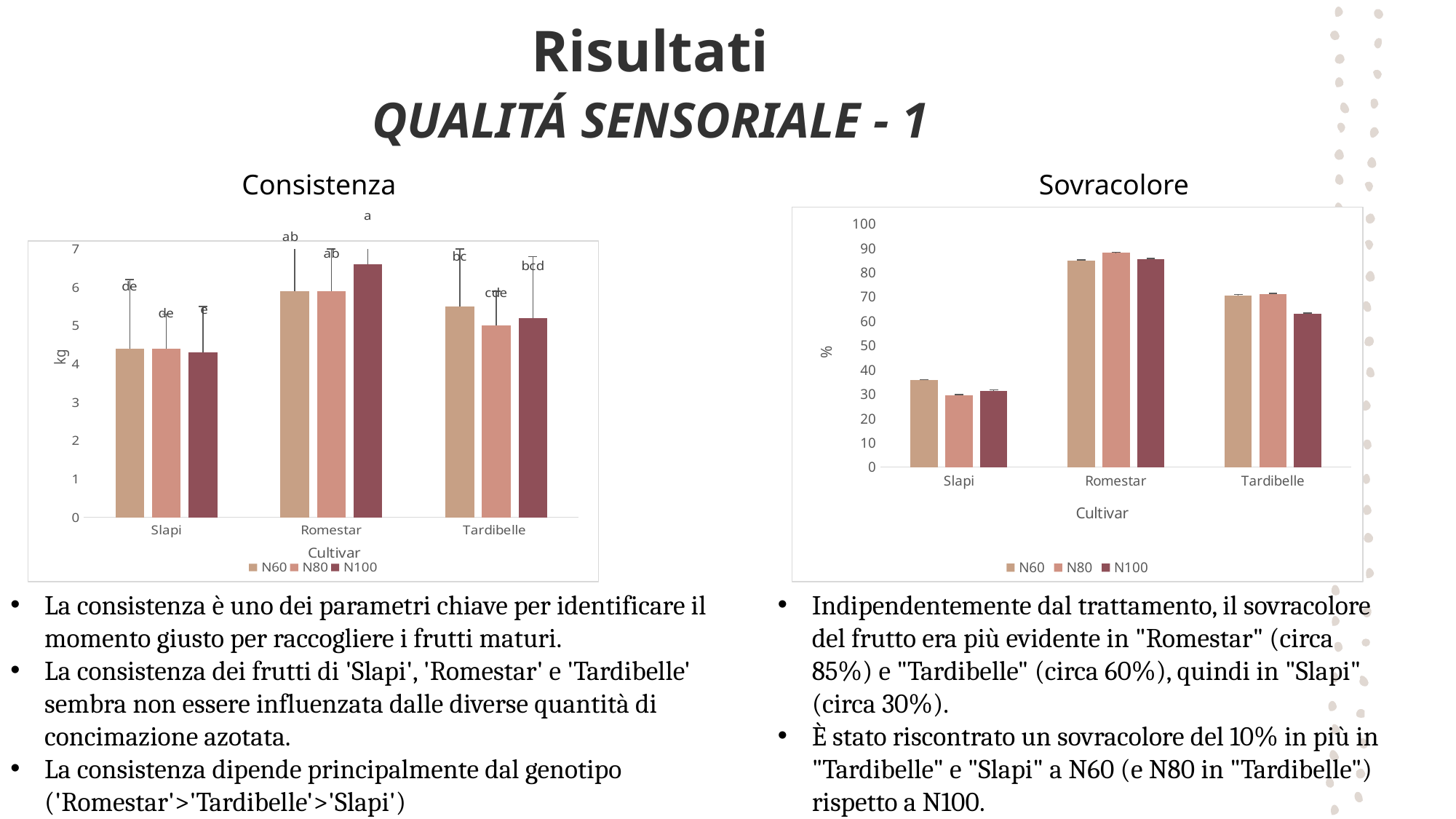
In the Sovracolore chart, is the N100 value for Tardibelle greater or less than 70? less What is the y-axis label of the Sovracolore chart? % In the Consistenza chart, which cultivar has the highest N100 bar? Romestar In the Sovracolore chart, is the N80 value for Romestar greater or less than 80? greater In the Sovracolore chart, which cultivar has the lowest N80 bar? Slapi In the Consistenza chart, is the N100 value for Romestar greater or less than 6? greater How many cultivars are shown on the x axis of the Consistenza chart? 3 How many series does the legend of the Sovracolore chart list? 3 What kind of chart is the Consistenza chart? bar chart In the Sovracolore chart, which is larger: the N60 value for Romestar or the N60 value for Tardibelle? Romestar